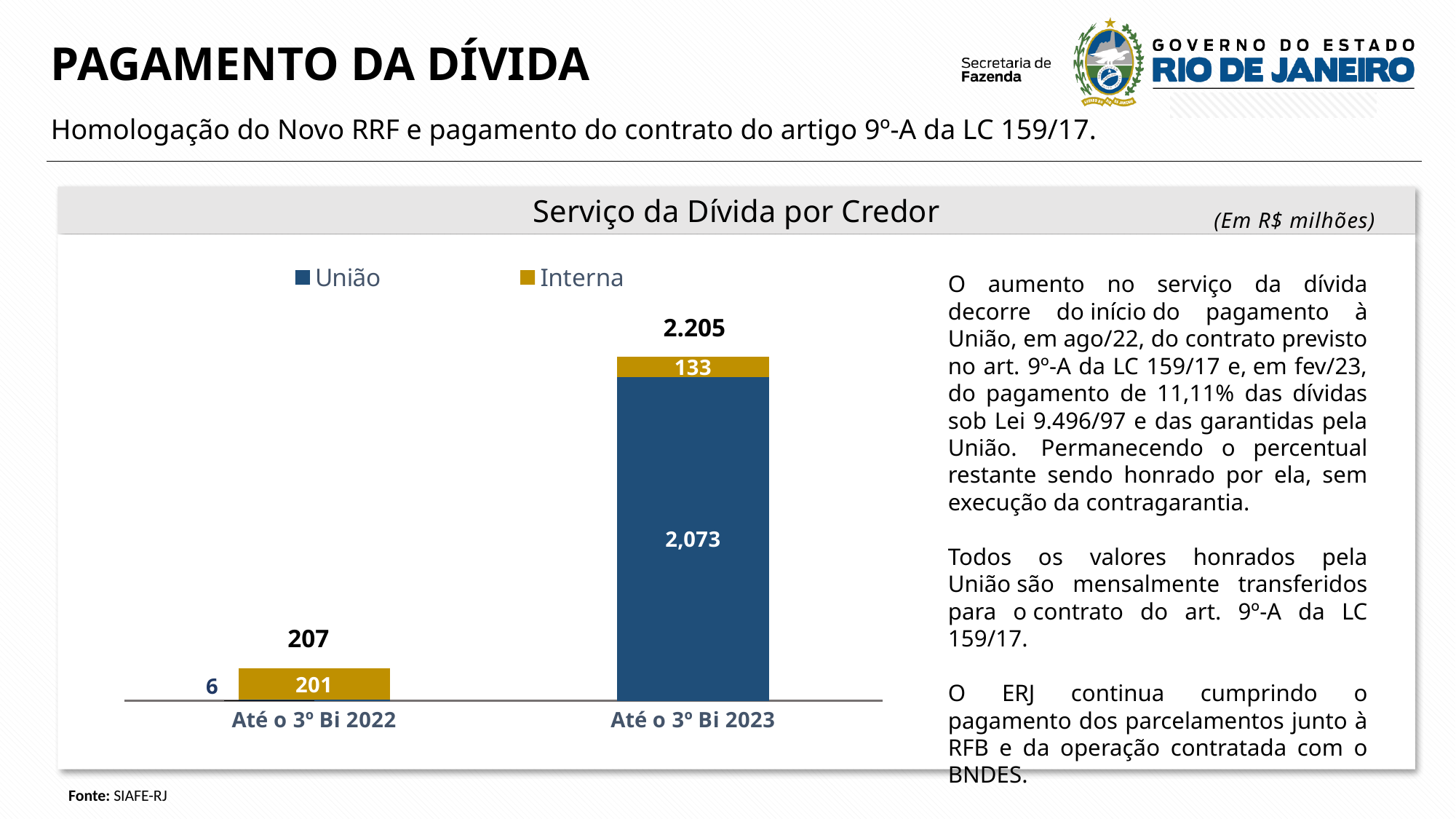
What is the value for União in the 'Até o 3º Bi 2023' bar? 2,073 What is the total shown above the 'Até o 3º Bi 2022' stacked bar? 207 What is the total shown above the 'Até o 3º Bi 2023' stacked bar? 2.205 What is the value for União in the 'Até o 3º Bi 2022' bar? 6 What is the difference between the Interna values for 'Até o 3º Bi 2022' and 'Até o 3º Bi 2023'? 68 What is the value for Interna in the 'Até o 3º Bi 2022' bar? 201 Which category has the higher total, 'Até o 3º Bi 2022' or 'Até o 3º Bi 2023'? Até o 3º Bi 2023 What is the value for Interna in the 'Até o 3º Bi 2023' bar? 133 How many series does the legend list? 2 How many categories are shown on the x axis? 2 Which series has the larger value in the 'Até o 3º Bi 2022' bar, União or Interna? Interna What is the title of the chart? Serviço da Dívida por Credor